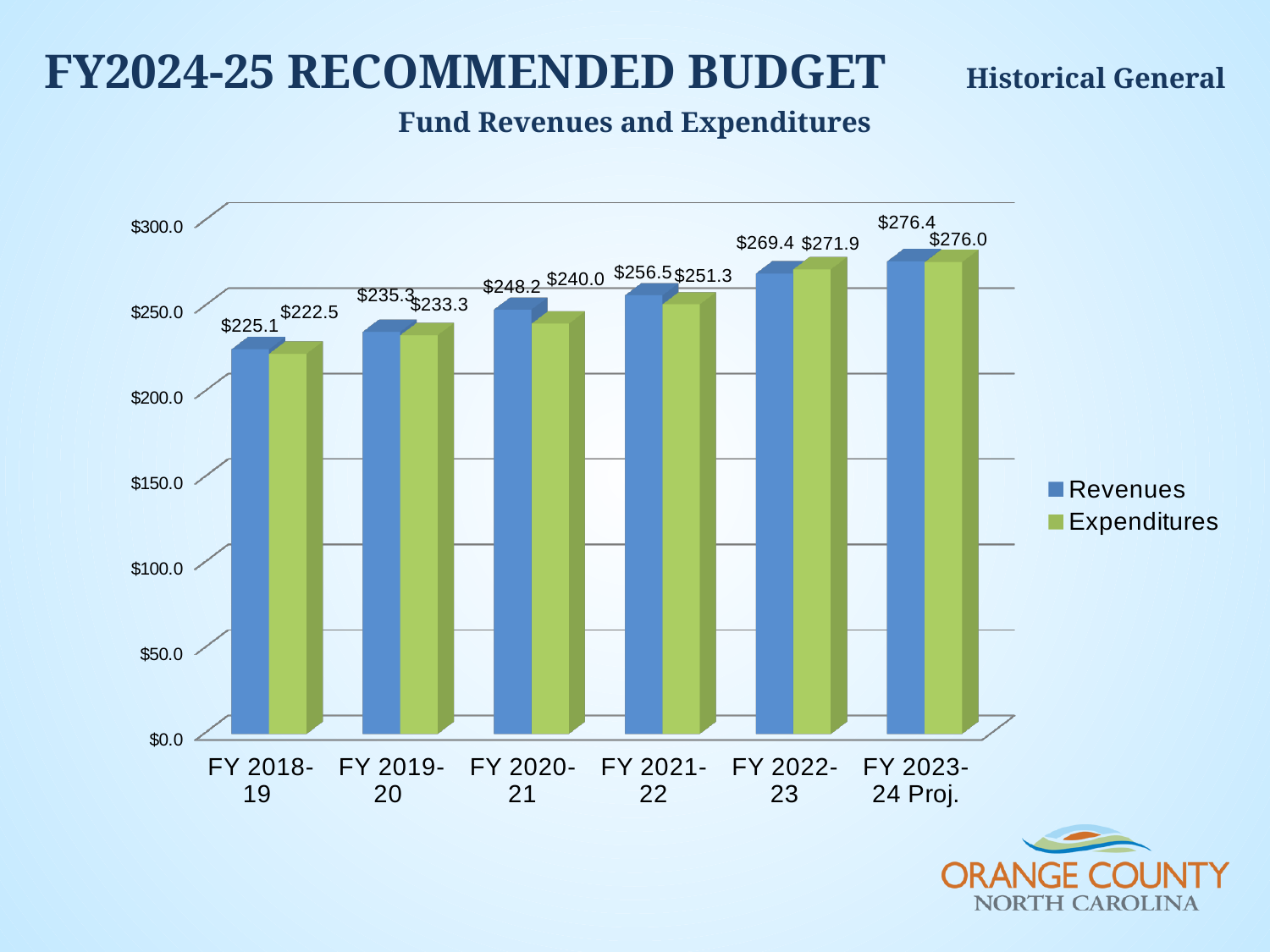
In FY 2022-23, which is larger, Revenues or Expenditures? Expenditures Which fiscal year has the lowest Expenditures value? FY 2018-19 What is the Expenditures value for FY 2022-23? $271.9 What is the Revenues value for FY 2018-19? $225.1 Is the Revenues value for FY 2021-22 greater or less than $250.0? greater How many series does the legend list? 2 How many fiscal years are shown on the x axis? 6 What kind of chart is shown on the slide? Bar chart What is the difference between Revenues and Expenditures in FY 2020-21? $8.2 Do the Revenues values rise or fall from FY 2018-19 to FY 2023-24 Proj.? Rise Which fiscal year has the highest Revenues value? FY 2023-24 Proj. What is the Revenues value for FY 2023-24 Proj.? $276.4